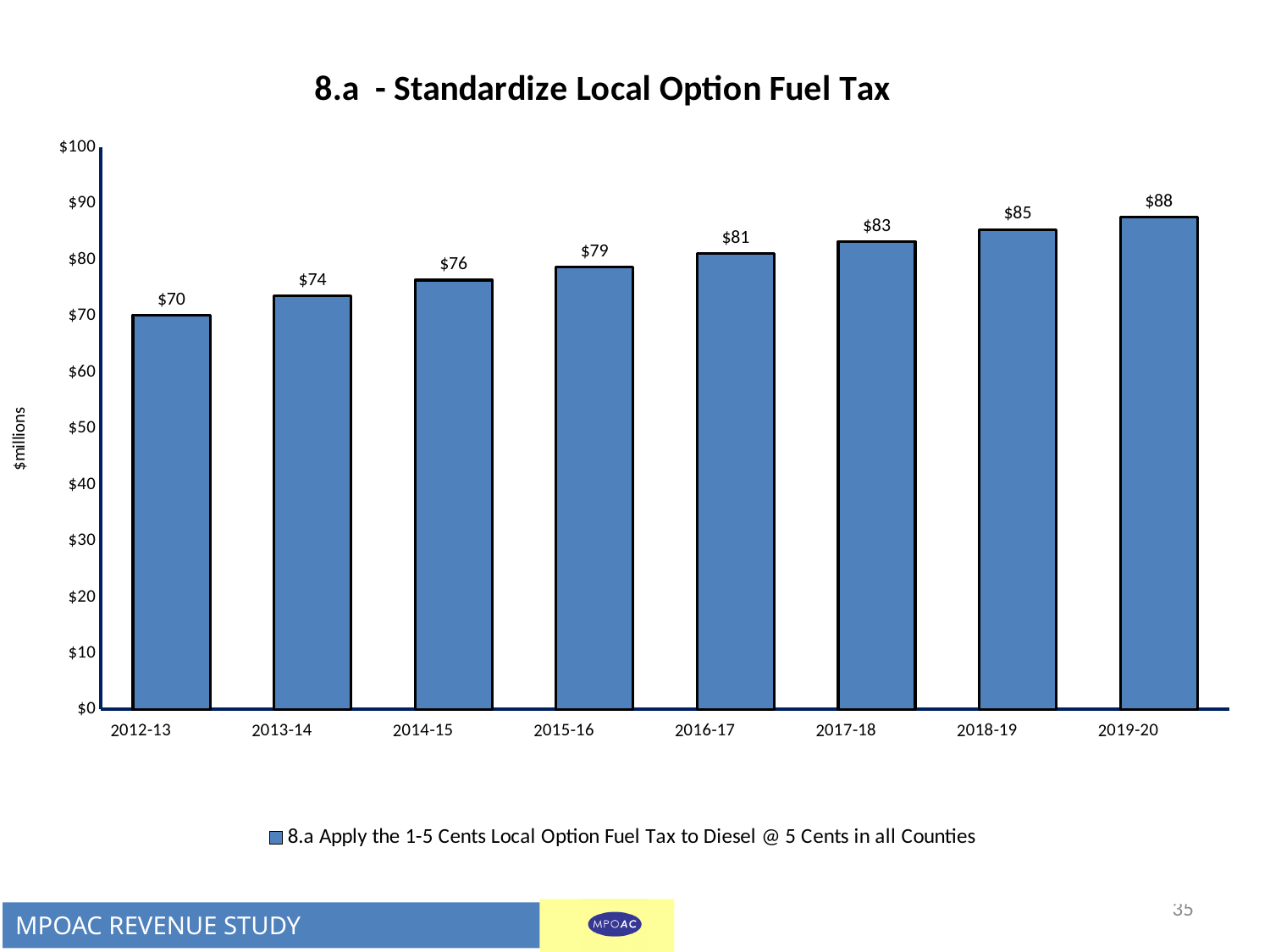
What is the difference between the values for 2015-16 and 2014-15? $3 What is the title of the chart? 8.a - Standardize Local Option Fuel Tax Which year has the lowest value? 2012-13 What is the difference between the values for 2019-20 and 2012-13? $18 What is the value for 2019-20? $88 How many years are shown on the x axis? 8 Which year has the highest value? 2019-20 What kind of chart is this? bar chart Which is larger, the value for 2017-18 or the value for 2013-14? 2017-18 What is the value for 2012-13? $70 What is the value for 2016-17? $81 Do the values rise or fall from 2012-13 to 2019-20? rise